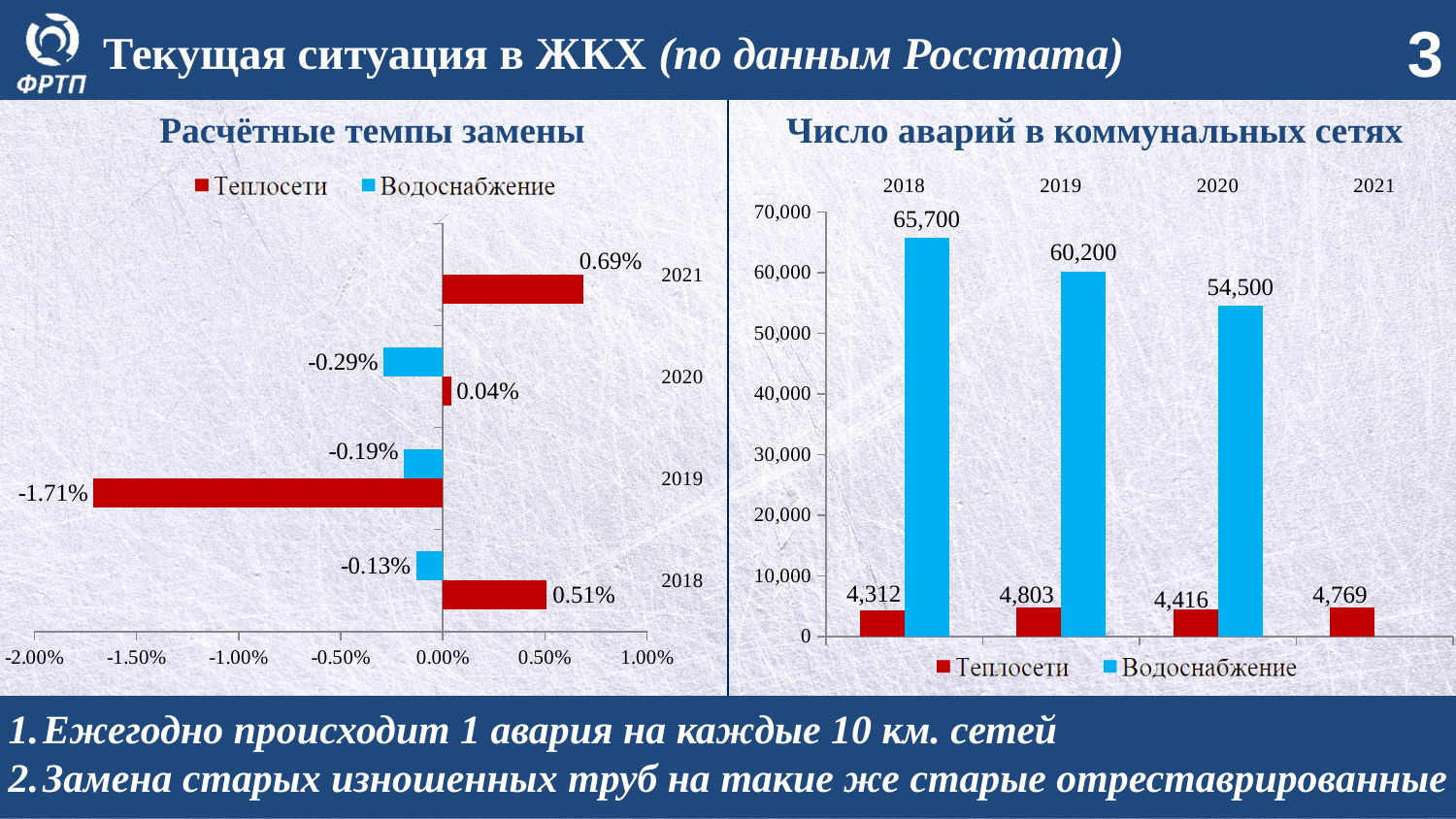
In the chart 'Число аварий в коммунальных сетях', what is the value for Теплосети in 2019? 4,803 In the chart 'Расчётные темпы замены', what is the value for Водоснабжение in 2020? -0.29% In the chart 'Число аварий в коммунальных сетях', which year has the larger Теплосети value, 2019 or 2021? 2019 In the chart 'Расчётные темпы замены', what is the value for Теплосети in 2019? -1.71% In the chart 'Число аварий в коммунальных сетях', what is the value for Водоснабжение in 2018? 65,700 In the chart 'Число аварий в коммунальных сетях', what is the difference between the Водоснабжение values for 2018 and 2019? 5,500 In the chart 'Расчётные темпы замены', which year has the lowest value for Теплосети? 2019 In the chart 'Число аварий в коммунальных сетях', which year has the highest value for Водоснабжение? 2018 What kind of chart is 'Расчётные темпы замены'? bar chart In the chart 'Число аварий в коммунальных сетях', do the Водоснабжение values rise or fall from 2018 to 2020? fall In the chart 'Число аварий в коммунальных сетях', which year has the lowest value for Теплосети? 2018 How many series does the legend of the chart 'Число аварий в коммунальных сетях' list? 2